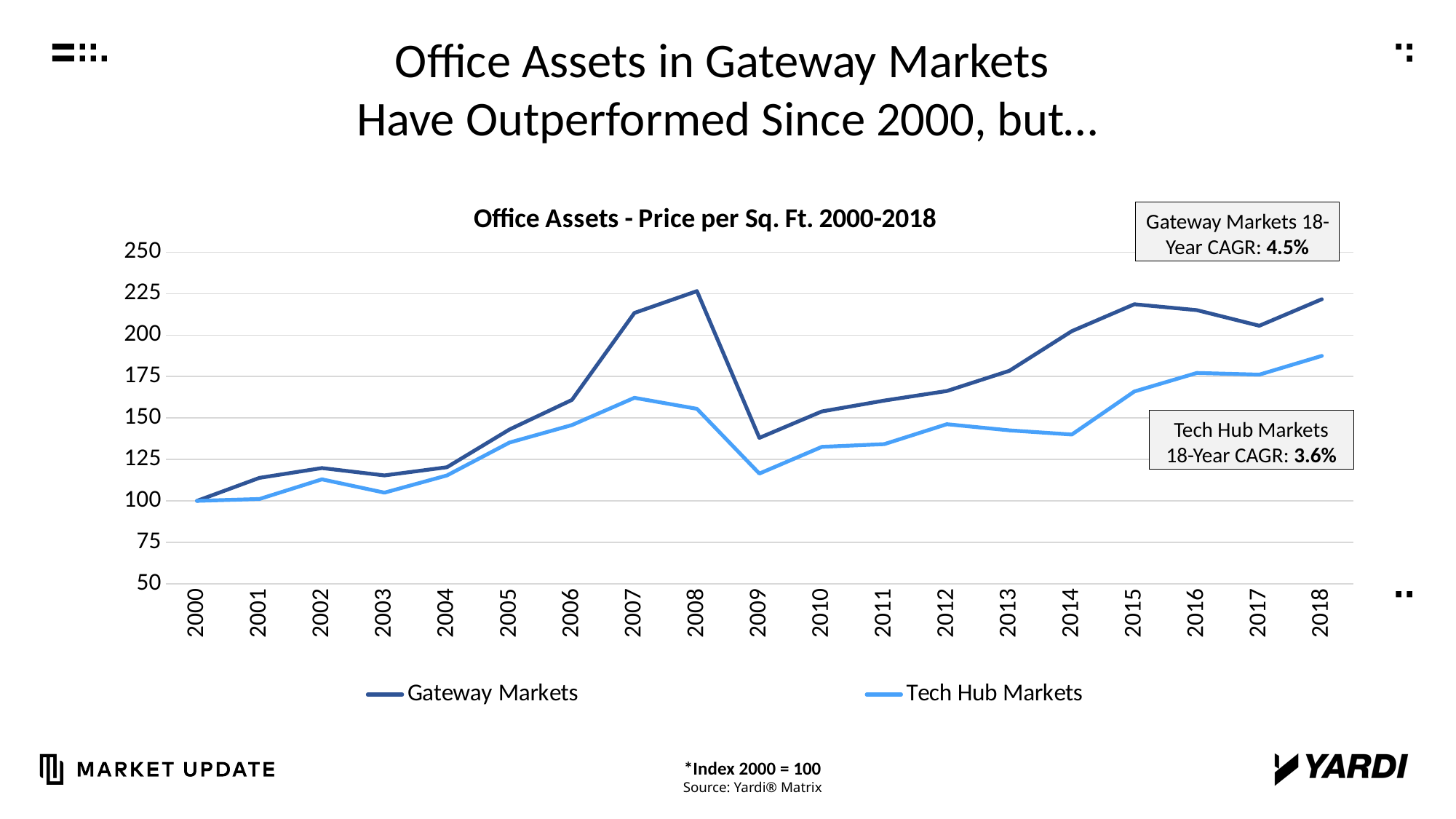
Does the Gateway Markets line rise or fall between 2009 and 2015? rise What is the value for Gateway Markets in 2000? 100 In which year is the Gateway Markets line at its lowest value? 2000 In which year does the Gateway Markets line reach its highest value? 2008 What kind of chart is shown on the slide? line chart Is the value for Tech Hub Markets in 2018 greater or less than 175? greater Is the value for Gateway Markets in 2007 greater or less than 200? greater How many years are plotted along the x axis? 19 What 18-year CAGR is shown for Tech Hub Markets in the annotation box? 3.6% How many series does the legend list? 2 Is the value for Tech Hub Markets in 2009 greater or less than 125? less Which series has the higher value in 2008, Gateway Markets or Tech Hub Markets? Gateway Markets